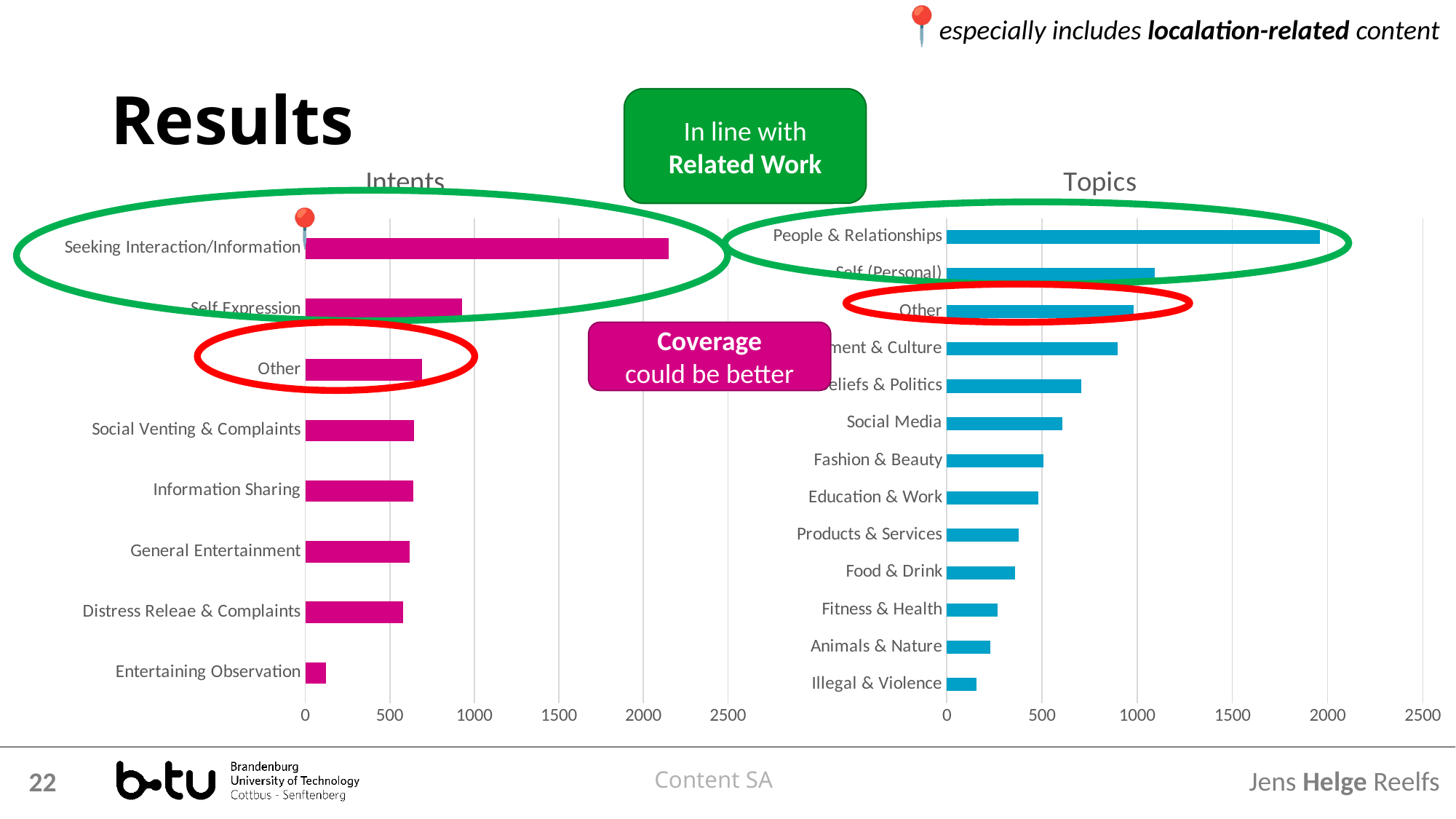
In the Intents chart, which category has the lowest value? Entertaining Observation In the Intents chart, which is larger, Self Expression or Other? Self Expression In the Topics chart, is the value for People & Relationships greater or less than 1500? greater In the Intents chart, is the value for Seeking Interaction/Information greater or less than 2000? greater In the Intents chart, is the value for Self Expression greater or less than 1000? less How many categories are shown in the Topics chart? 13 What kind of chart is the Intents chart on the left? bar chart In the Topics chart, which is larger, Social Media or Food & Drink? Social Media In the Topics chart, which category has the lowest value? Illegal & Violence In the Intents chart, which category has the highest value? Seeking Interaction/Information In the Topics chart, which category has the highest value? People & Relationships How many categories are shown in the Intents chart? 8